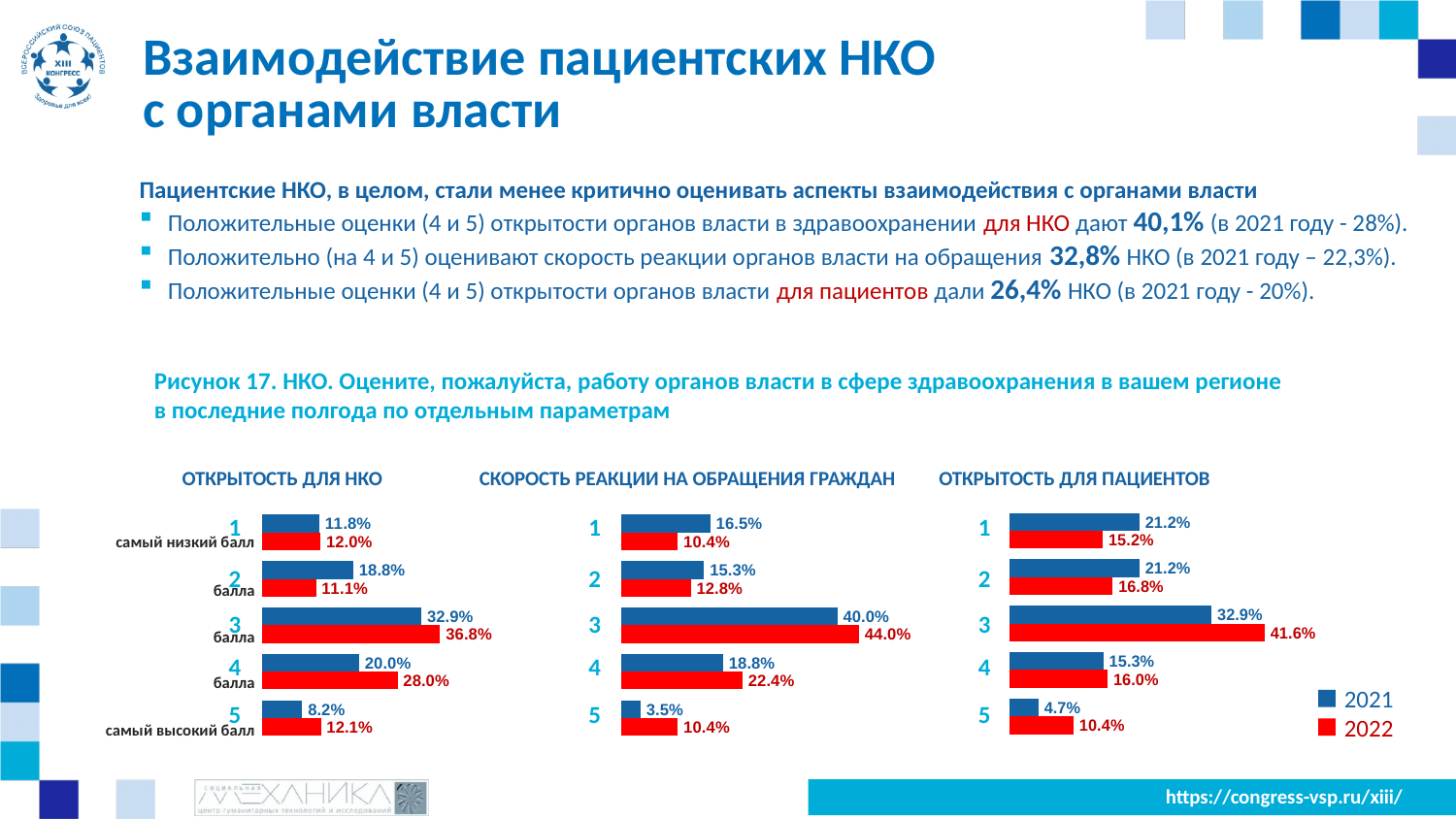
In the chart titled "СКОРОСТЬ РЕАКЦИИ НА ОБРАЩЕНИЯ ГРАЖДАН", what is the difference between the 2022 and 2021 values for category 4? 3.6% In the chart titled "ОТКРЫТОСТЬ ДЛЯ НКО", which category has the highest 2021 value? 3 In the chart titled "ОТКРЫТОСТЬ ДЛЯ НКО", what is the 2022 value for category 3? 36.8% Which colour represents the 2022 series in the charts? Red In the chart titled "ОТКРЫТОСТЬ ДЛЯ ПАЦИЕНТОВ", what is the 2022 value for category 3? 41.6% In the chart titled "СКОРОСТЬ РЕАКЦИИ НА ОБРАЩЕНИЯ ГРАЖДАН", what is the 2021 value for category 5? 3.5% How many series does the legend on the slide list? 2 In the chart titled "ОТКРЫТОСТЬ ДЛЯ НКО", which is larger for category 4: the 2021 value or the 2022 value? 2022 How many categories does the chart titled "ОТКРЫТОСТЬ ДЛЯ ПАЦИЕНТОВ" show? 5 In the chart titled "СКОРОСТЬ РЕАКЦИИ НА ОБРАЩЕНИЯ ГРАЖДАН", which category has the lowest 2021 value? 5 What kind of chart is the chart titled "ОТКРЫТОСТЬ ДЛЯ НКО"? Bar chart In the chart titled "ОТКРЫТОСТЬ ДЛЯ ПАЦИЕНТОВ", what is the difference between the 2022 and 2021 values for category 3? 8.7%